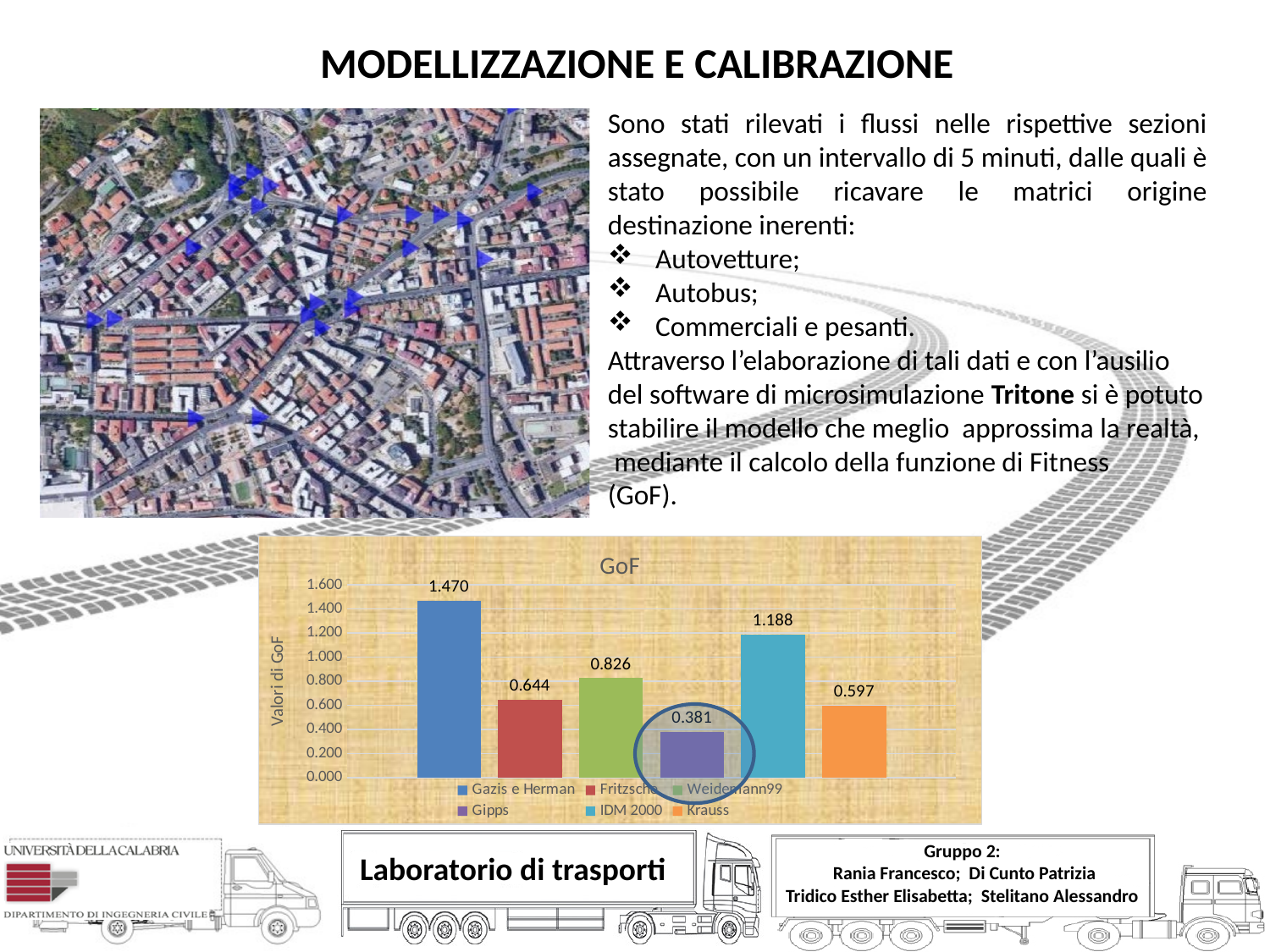
What is the GoF value for IDM 2000? 1.188 Which model has the lowest GoF value? Gipps Which model has the highest GoF value? Gazis e Herman How many bars are plotted in the GoF chart? 6 Which has a larger GoF value, Fritzsche or Weidemann99? Weidemann99 What is the label of the vertical axis of the GoF chart? Valori di GoF Is the GoF value for IDM 2000 greater or less than 1.000? greater What is the GoF value for Gipps? 0.381 What is the GoF value for Krauss? 0.597 What is the GoF value for Gazis e Herman? 1.470 What kind of chart is the GoF chart? bar chart What is the difference between the GoF values of Gazis e Herman and Gipps? 1.089